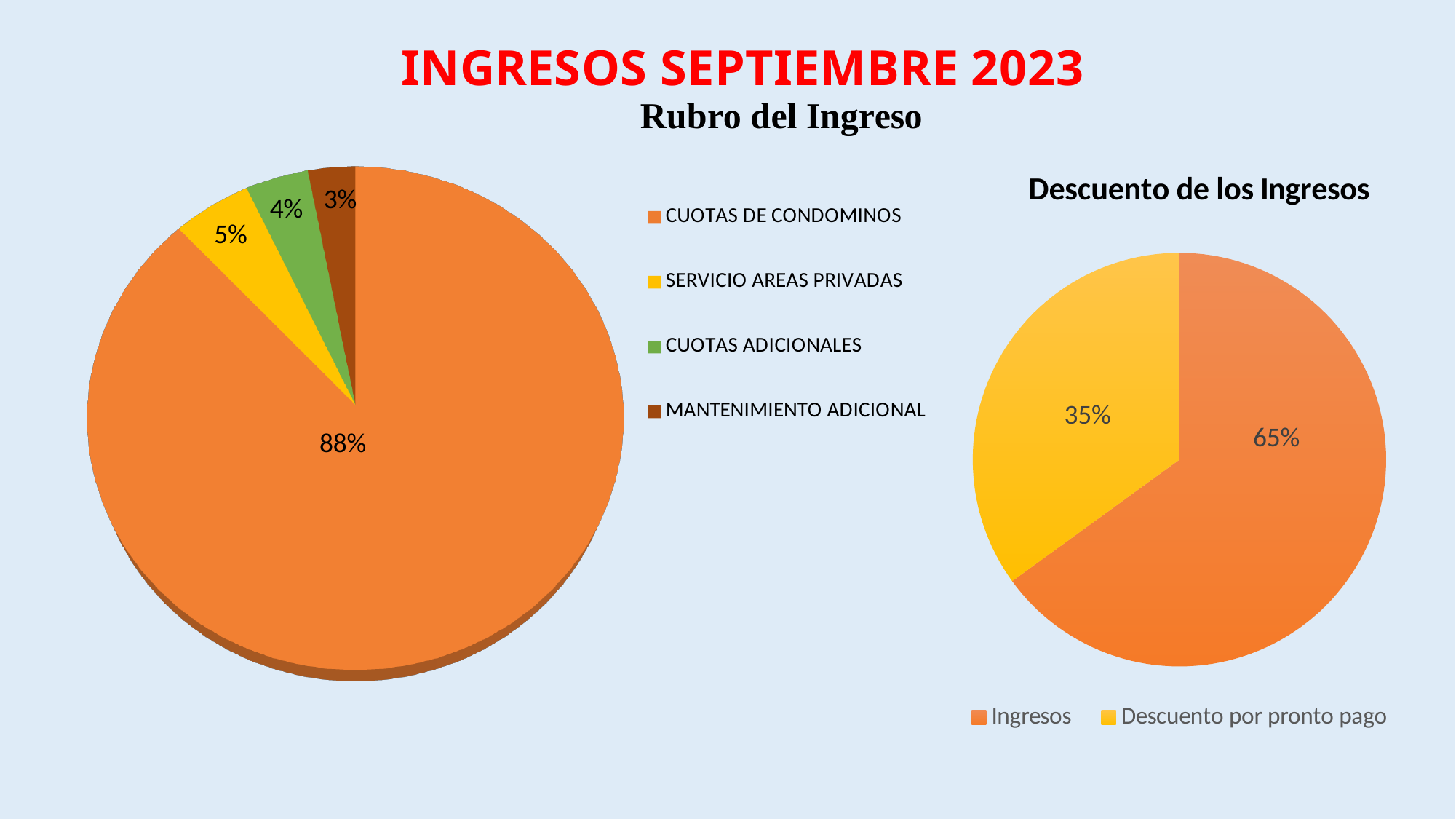
In the 'Rubro del Ingreso' chart, what share does CUOTAS ADICIONALES have? 4% In the 'Rubro del Ingreso' chart, what share does MANTENIMIENTO ADICIONAL have? 3% In the 'Rubro del Ingreso' chart, which category has the smallest slice? MANTENIMIENTO ADICIONAL In the 'Rubro del Ingreso' chart, what share does CUOTAS DE CONDOMINOS have? 88% What kind of chart is 'Descuento de los Ingresos'? Pie chart In the 'Rubro del Ingreso' chart, what is the difference between the shares of CUOTAS DE CONDOMINOS and SERVICIO AREAS PRIVADAS? 83% In the 'Descuento de los Ingresos' chart, which is larger, Ingresos or Descuento por pronto pago? Ingresos In the 'Rubro del Ingreso' chart, which category has the largest slice? CUOTAS DE CONDOMINOS In the 'Rubro del Ingreso' chart, how many categories are shown? 4